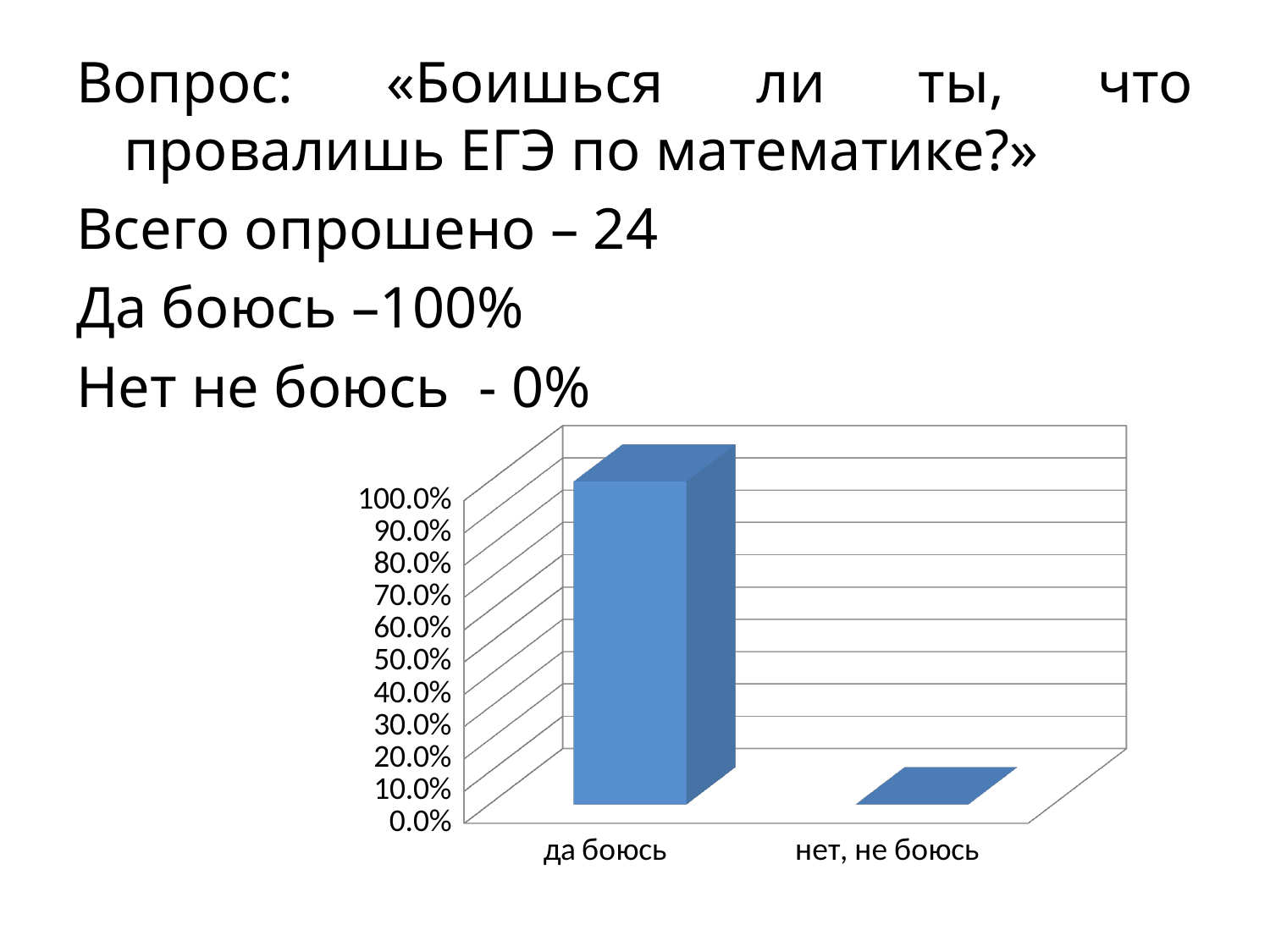
What is the difference between the values for "да боюсь" and "нет, не боюсь"? 100.0% Which category has the lowest value in the chart? нет, не боюсь Which is larger, the value for "да боюсь" or the value for "нет, не боюсь"? да боюсь What is the highest tick label shown on the vertical axis of the chart? 100.0% Which category has the highest value in the chart? да боюсь How many categories are shown on the x axis of the chart? 2 What is the label of the first category on the x axis of the chart? да боюсь What is the value for "нет, не боюсь" in the chart? 0.0% Is the value for "нет, не боюсь" greater or less than 10.0%? less Is the value for "да боюсь" greater or less than 50.0%? greater What is the value for "да боюсь" in the chart? 100.0% What kind of chart is shown on the slide? bar chart